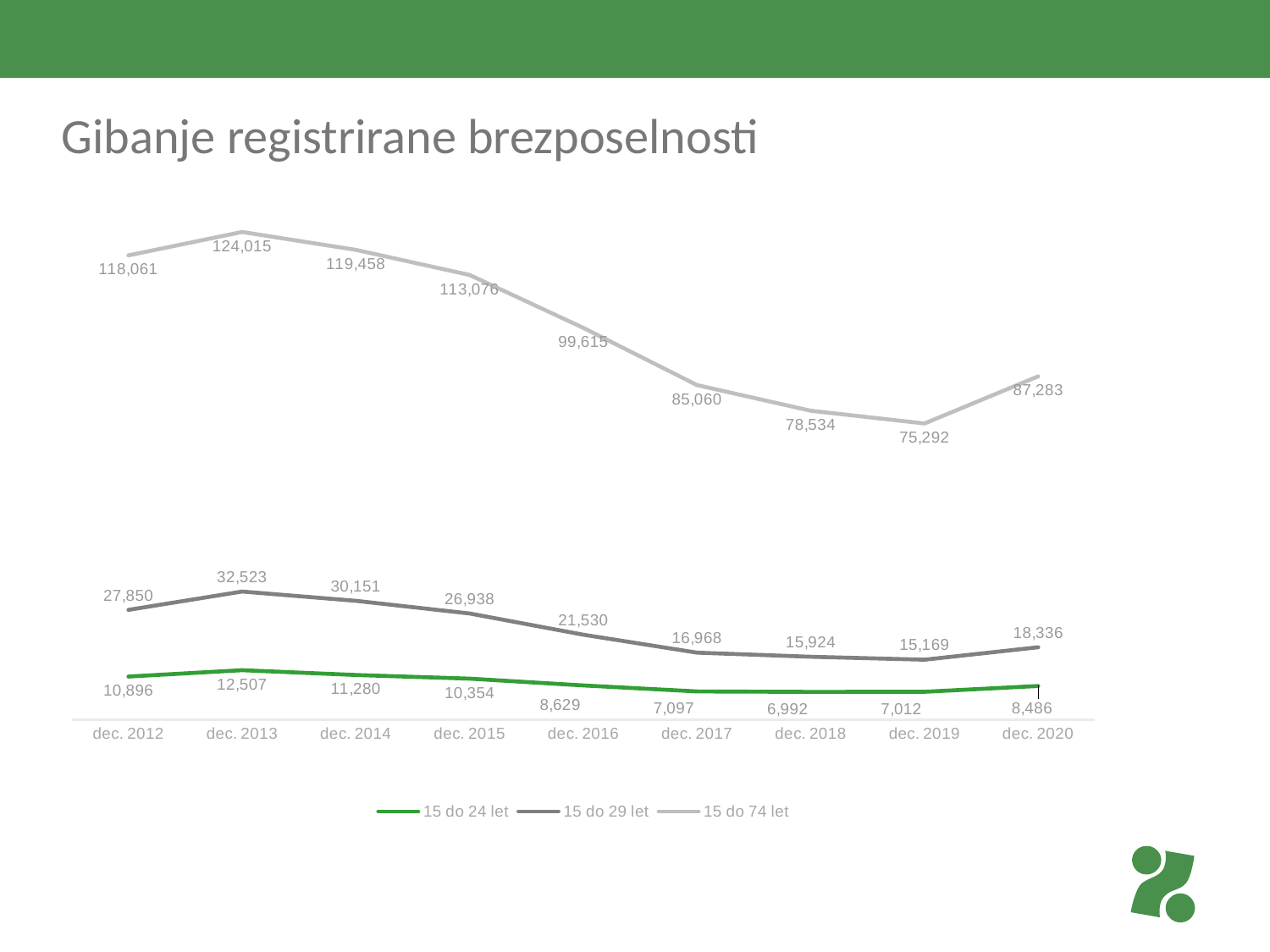
Which is larger: the "15 do 29 let" value in dec. 2013 or in dec. 2014? dec. 2013 What is the value for the "15 do 74 let" series in dec. 2013? 124,015 What is the value for the "15 do 29 let" series in dec. 2020? 18,336 What is the difference between the "15 do 74 let" values in dec. 2012 and dec. 2020? 30,778 How many time points are shown on the x axis? 9 In which period does the "15 do 24 let" series reach its lowest value? dec. 2018 In which period does the "15 do 74 let" series reach its highest value? dec. 2013 What kind of chart is shown on the slide? line chart Does the "15 do 74 let" series rise or fall between dec. 2013 and dec. 2019? fall How many series does the legend list? 3 What is the title of the chart? Gibanje registrirane brezposelnosti What is the value for the "15 do 24 let" series in dec. 2018? 6,992